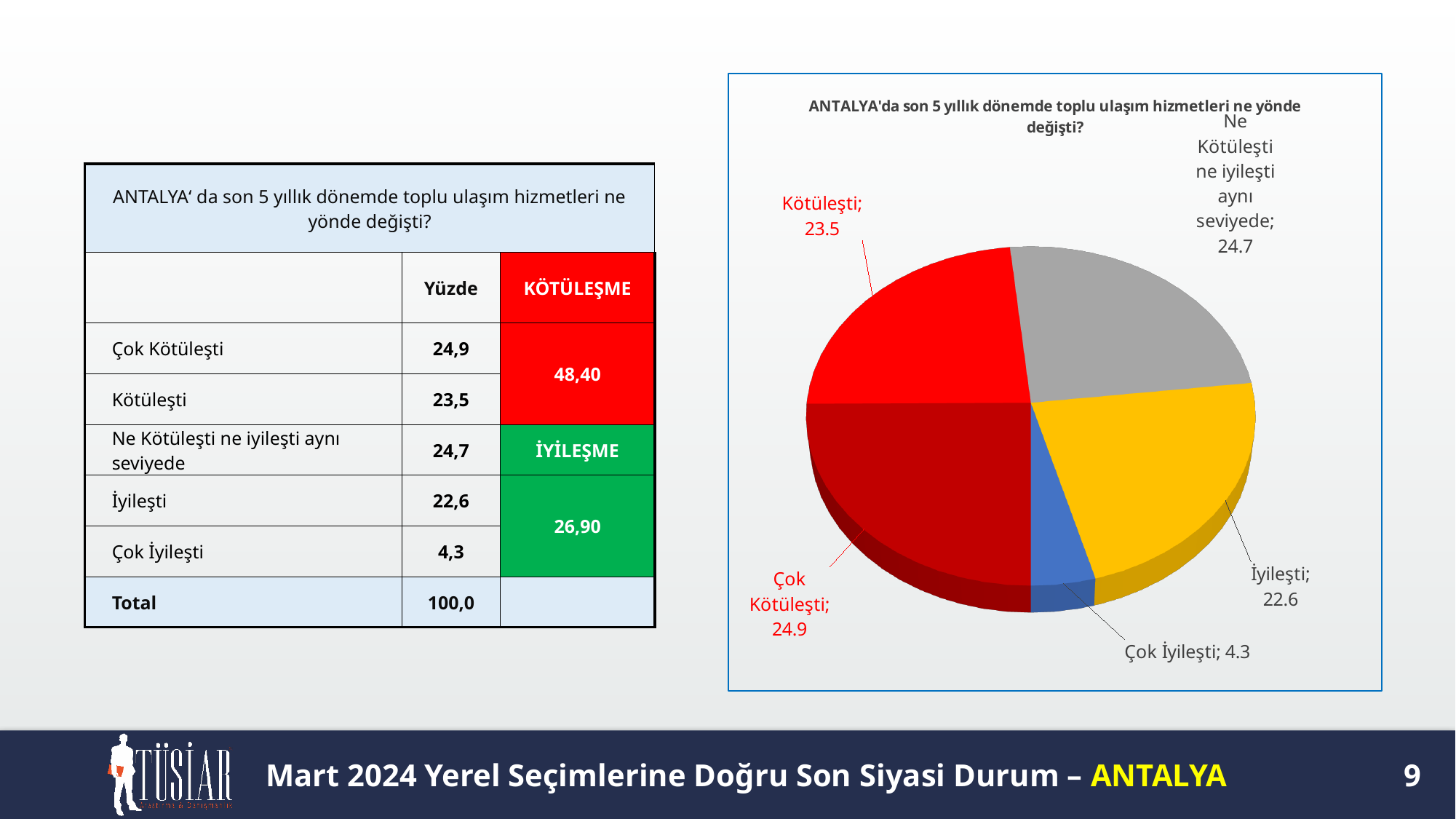
How many slices does the pie chart have? 5 What kind of chart is shown on the slide? pie chart Which slice of the pie chart is the smallest? Çok İyileşti In the pie chart, what is the value for Kötüleşti? 23.5 In the pie chart, which is larger: İyileşti or Çok İyileşti? İyileşti What share of the pie does the Çok İyileşti slice represent? 4.3 In the pie chart, what is the value for İyileşti? 22.6 In the pie chart, what is the value for Ne Kötüleşti ne iyileşti aynı seviyede? 24.7 In the pie chart, what is the difference between Çok Kötüleşti and Çok İyileşti? 20.6 What colour is the Çok İyileşti slice in the pie chart? blue In the pie chart, what is the value for Çok Kötüleşti? 24.9 In the pie chart, what is the difference between Ne Kötüleşti ne iyileşti aynı seviyede and İyileşti? 2.1